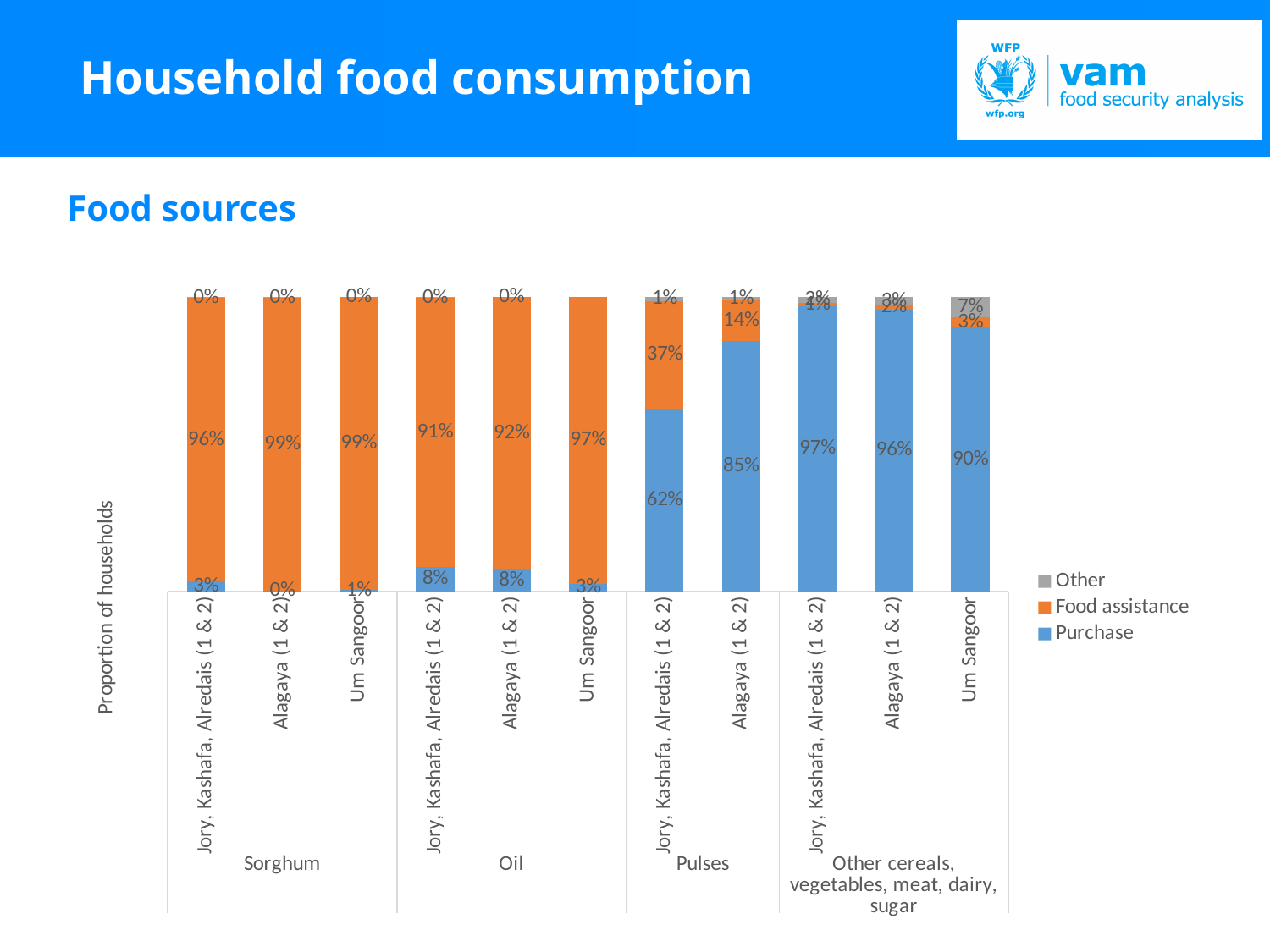
In the Pulses group, which has the larger Purchase share: Jory, Kashafa, Alredais (1 & 2) or Alagaya (1 & 2)? Alagaya (1 & 2) What is the Purchase share for Jory, Kashafa, Alredais (1 & 2) in the Pulses group? 62% In the Pulses group, how much higher is the Food assistance share for Jory, Kashafa, Alredais (1 & 2) than for Alagaya (1 & 2)? 23 percentage points How many series does the legend list? 3 What is the Food assistance share for Alagaya (1 & 2) in the Pulses group? 14% What is the Purchase share for Jory, Kashafa, Alredais (1 & 2) in the Oil group? 8% What is the Food assistance share for Alagaya (1 & 2) in the Sorghum group? 99% For Um Sangoor, which food group has the highest Purchase share? Other cereals, vegetables, meat, dairy, sugar What is the Food assistance share for Um Sangoor in the Oil group? 97% What kind of chart is shown on the slide? Stacked bar chart What is the Other share for Um Sangoor in the Other cereals, vegetables, meat, dairy, sugar group? 7% How many bars are plotted in the chart? 11